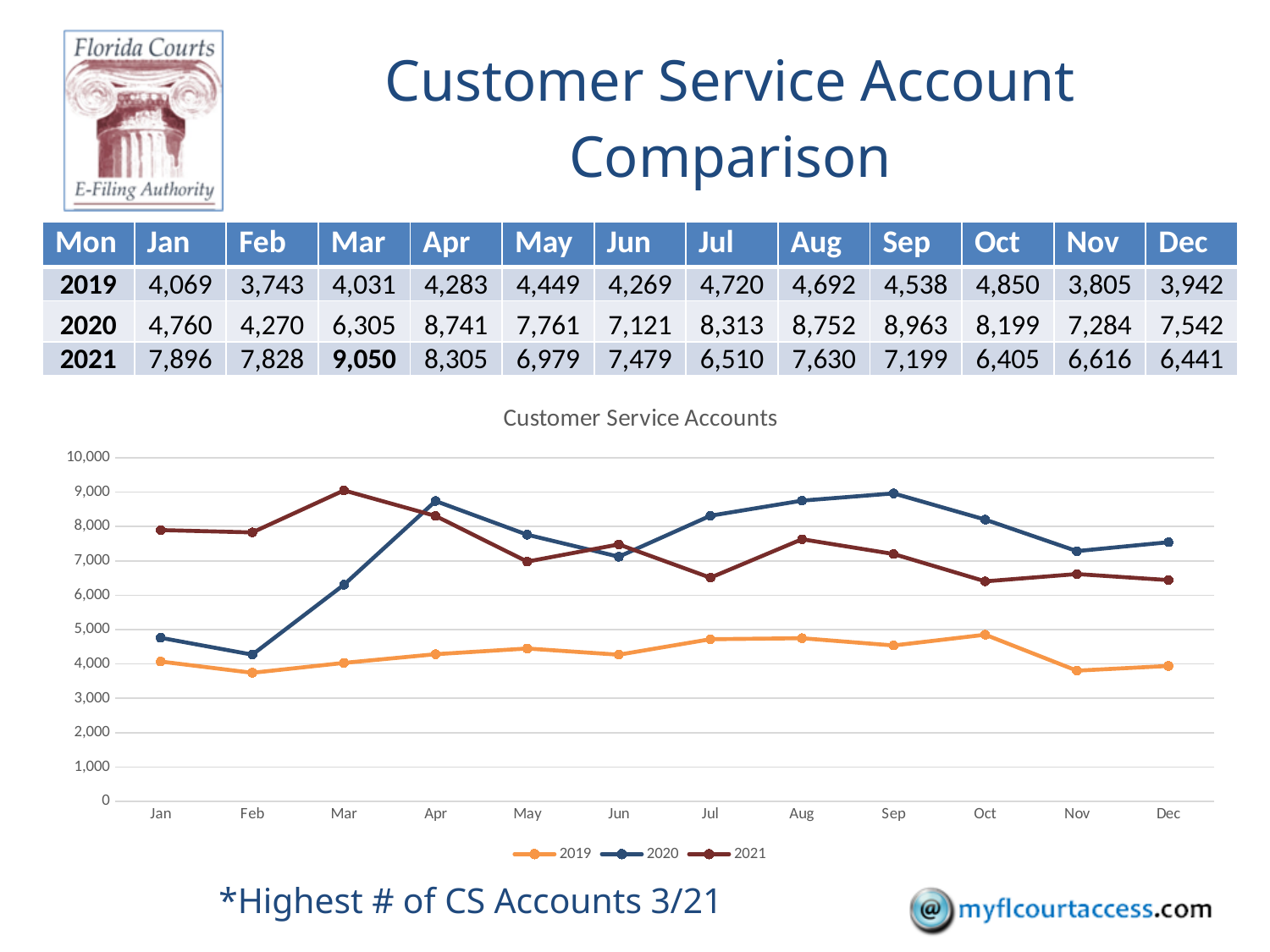
How many series does the chart legend list? 3 Does the 2020 series rise or fall from January to April? rise What is the difference between the 2021 and 2020 values in March? 2,745 What is the title of the chart? Customer Service Accounts Is the value for 2019 in October greater or less than 4,000? greater In which month is the 2019 series lowest? Feb What kind of chart is shown on the slide? line chart What is the value for 2021 in March? 9,050 What is the value for 2020 in September? 8,963 Which is larger in April, the 2020 value or the 2021 value? 2020 In which month is the 2020 series highest? Sep How many months are plotted along the x axis of the chart? 12